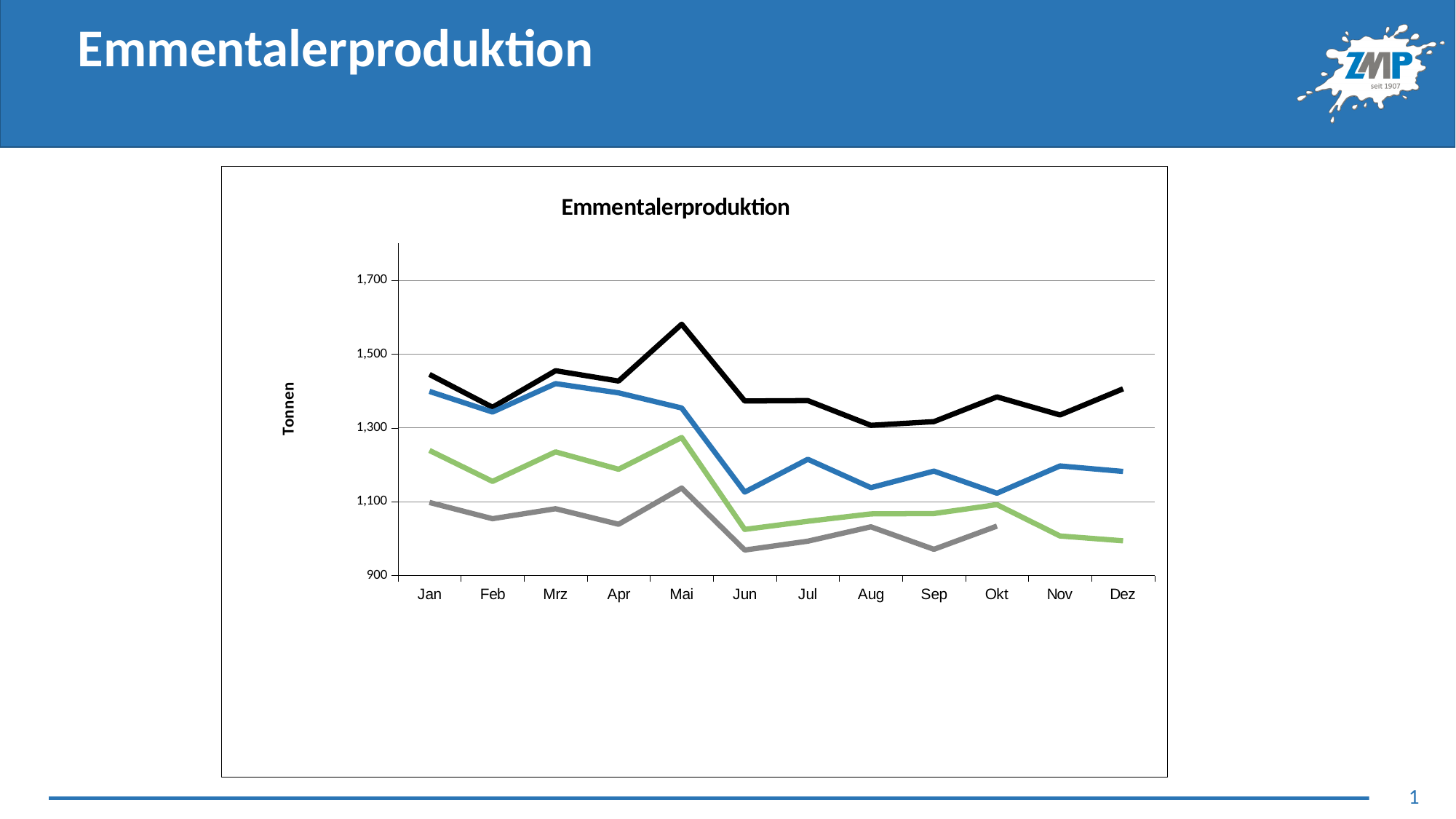
Is the value of the blue line in Jul greater or less than 1,100? greater In Jan, which line has the higher value, the black line or the blue line? the black line Does the black line rise or fall from Mai to Aug? fall In which month does the green line reach its highest value? Mai How many lines are plotted in the chart? 4 What kind of chart is shown on the slide? line chart What is the title of the chart? Emmentalerproduktion What is the label on the vertical axis of the chart? Tonnen How many months are shown on the x axis of the chart? 12 Is the value of the grey line in Jun greater or less than 1,000? less Is the value of the black line in Mai greater or less than 1,500? greater In which month does the black line reach its highest value? Mai